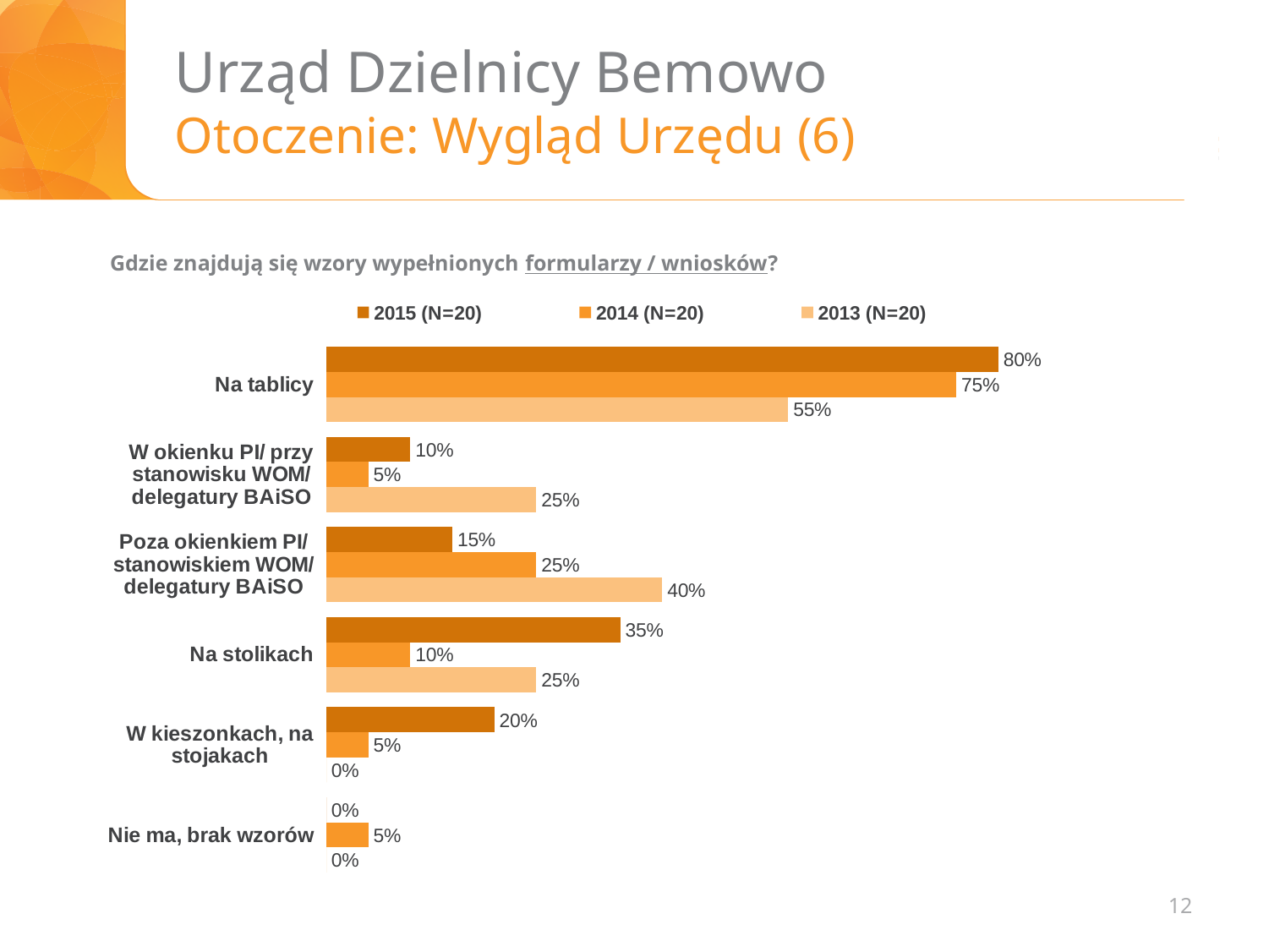
Which category has the highest value in the 2013 (N=20) series? Na tablicy What is the value for 'Na stolikach' in the 2014 (N=20) series? 10% Which category has the lowest value in the 2015 (N=20) series? Nie ma, brak wzorów What kind of chart is shown on the slide? Bar chart What question does the chart answer, according to the text above it? Gdzie znajdują się wzory wypełnionych formularzy / wniosków? What is the difference between the 2015 (N=20) and 2013 (N=20) values for 'Na tablicy'? 25% What is the value for 'Poza okienkiem PI/ stanowiskiem WOM/ delegatury BAiSO' in the 2013 (N=20) series? 40% What is the value for 'W kieszonkach, na stojakach' in the 2014 (N=20) series? 5% How many series does the legend list? 3 How many categories are shown on the chart? 6 Which is larger for 'W okienku PI/ przy stanowisku WOM/ delegatury BAiSO': the 2015 (N=20) value or the 2013 (N=20) value? 2013 (N=20) What is the value for 'Na tablicy' in the 2015 (N=20) series? 80%